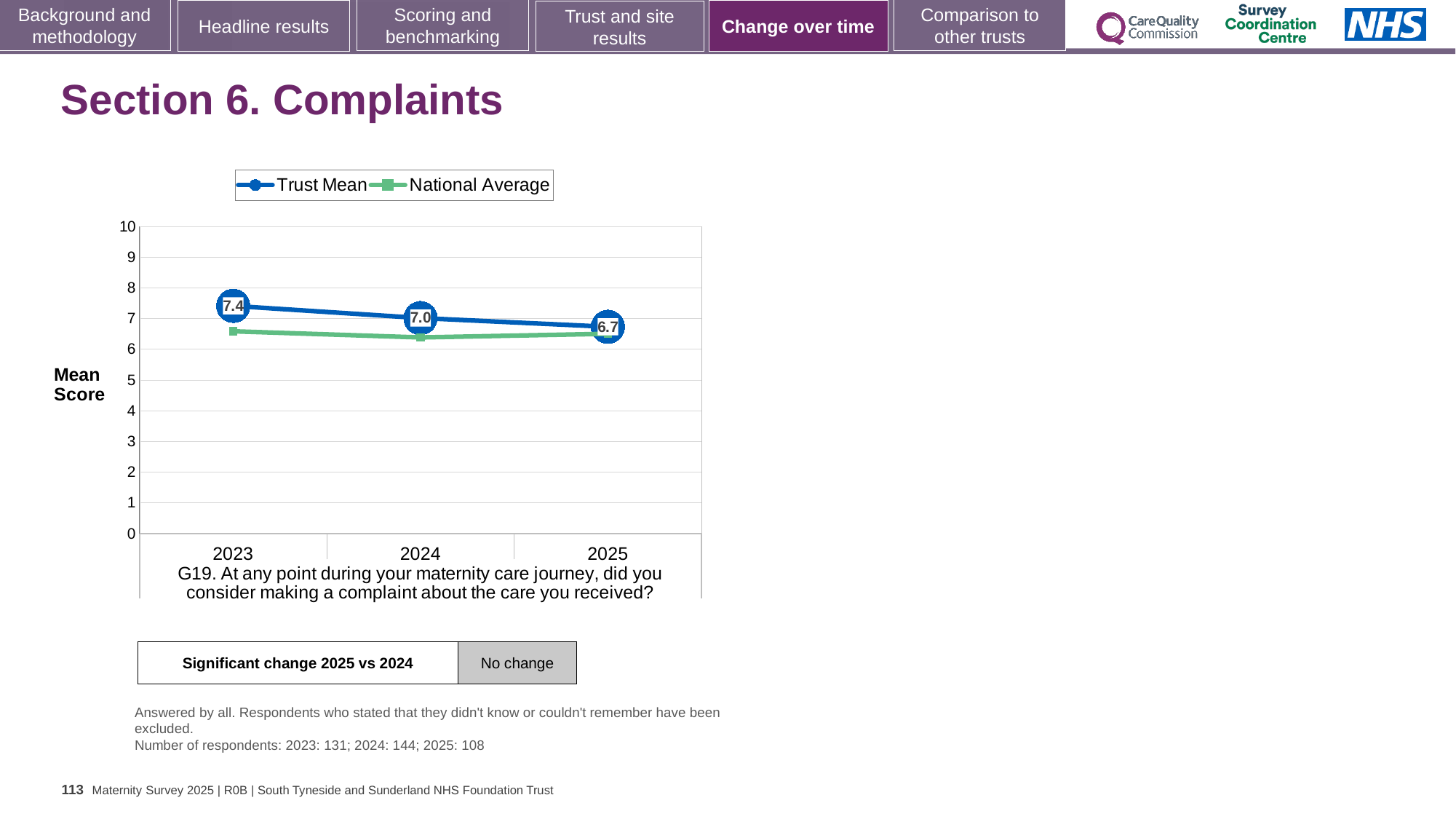
What is the Trust Mean value for 2023? 7.4 What is the Trust Mean value for 2024? 7.0 What kind of chart is shown on the slide? line chart How many series does the legend list? 2 In which year is the Trust Mean lowest? 2025 In which year is the Trust Mean highest? 2023 In 2023, which is larger: the Trust Mean or the National Average? Trust Mean Does the Trust Mean rise or fall from 2023 to 2025? fall How many years are plotted on the x axis? 3 Is the National Average value for 2024 greater or less than 7? less What is the difference between the Trust Mean in 2023 and in 2025? 0.7 What is the Trust Mean value for 2025? 6.7